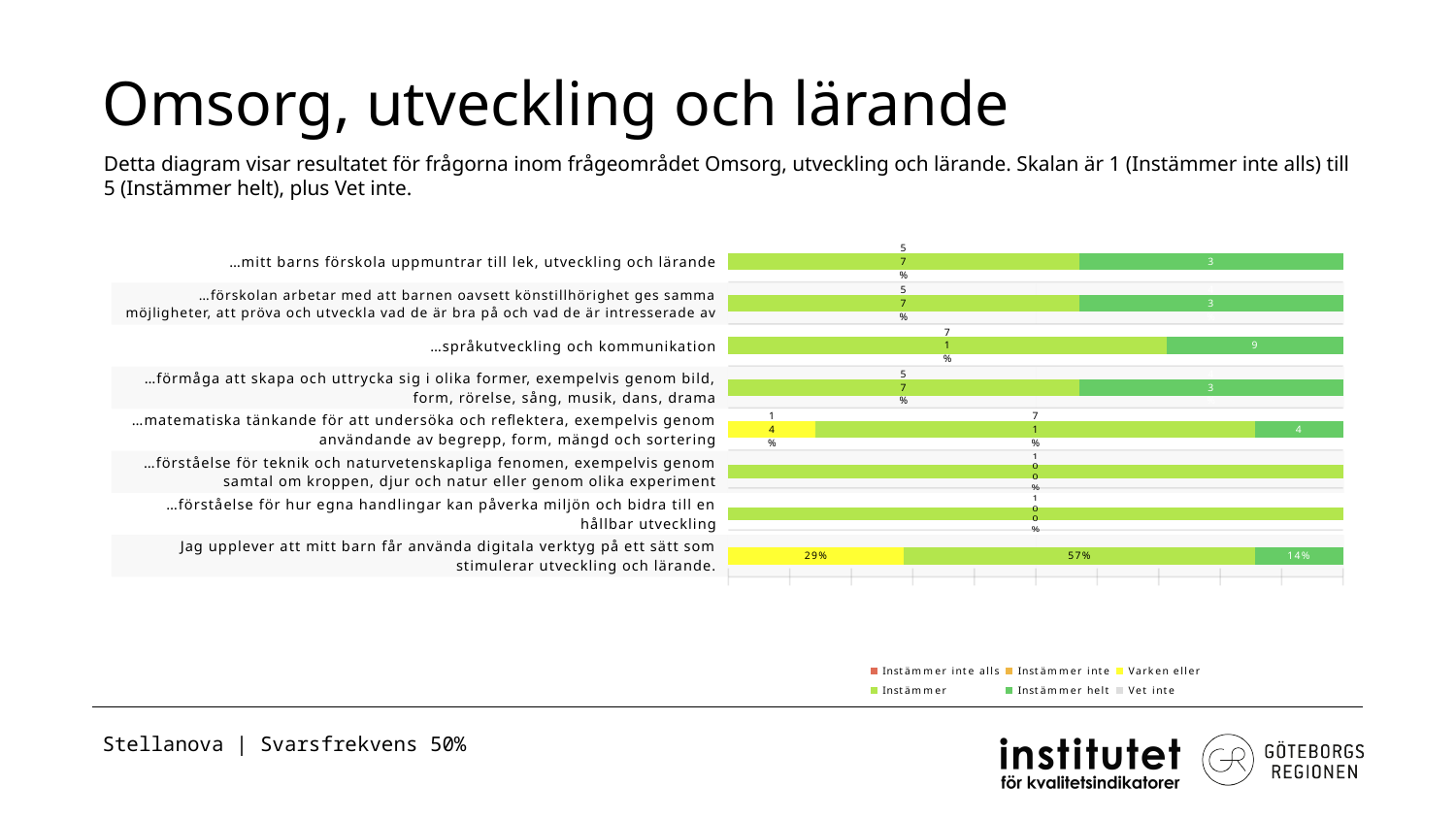
What is the total of the stacked bar for "Jag upplever att mitt barn får använda digitala verktyg på ett sätt som stimulerar utveckling och lärande."? 100% What is the value for "Instämmer" in the row "Jag upplever att mitt barn får använda digitala verktyg på ett sätt som stimulerar utveckling och lärande."? 57% What kind of chart is shown on the slide? bar chart What is the value for "Instämmer" in the row "...förståelse för teknik och naturvetenskapliga fenomen, exempelvis genom samtal om kroppen, djur och natur eller genom olika experiment"? 100% Which colour does the legend use for "Varken eller"? yellow How many question categories (rows) does the chart show? 8 How many series does the legend list? 6 What is the value for "Instämmer" in the row "...förståelse för hur egna handlingar kan påverka miljön och bidra till en hållbar utveckling"? 100% What is the value for "Instämmer helt" in the row "Jag upplever att mitt barn får använda digitala verktyg på ett sätt som stimulerar utveckling och lärande."? 14% In the row "Jag upplever att mitt barn får använda digitala verktyg...", what is the difference between the "Instämmer" value and the "Varken eller" value? 28% In the row "Jag upplever att mitt barn får använda digitala verktyg...", which is larger: "Instämmer" or "Instämmer helt"? Instämmer What is the value for "Varken eller" in the row "Jag upplever att mitt barn får använda digitala verktyg på ett sätt som stimulerar utveckling och lärande."? 29%